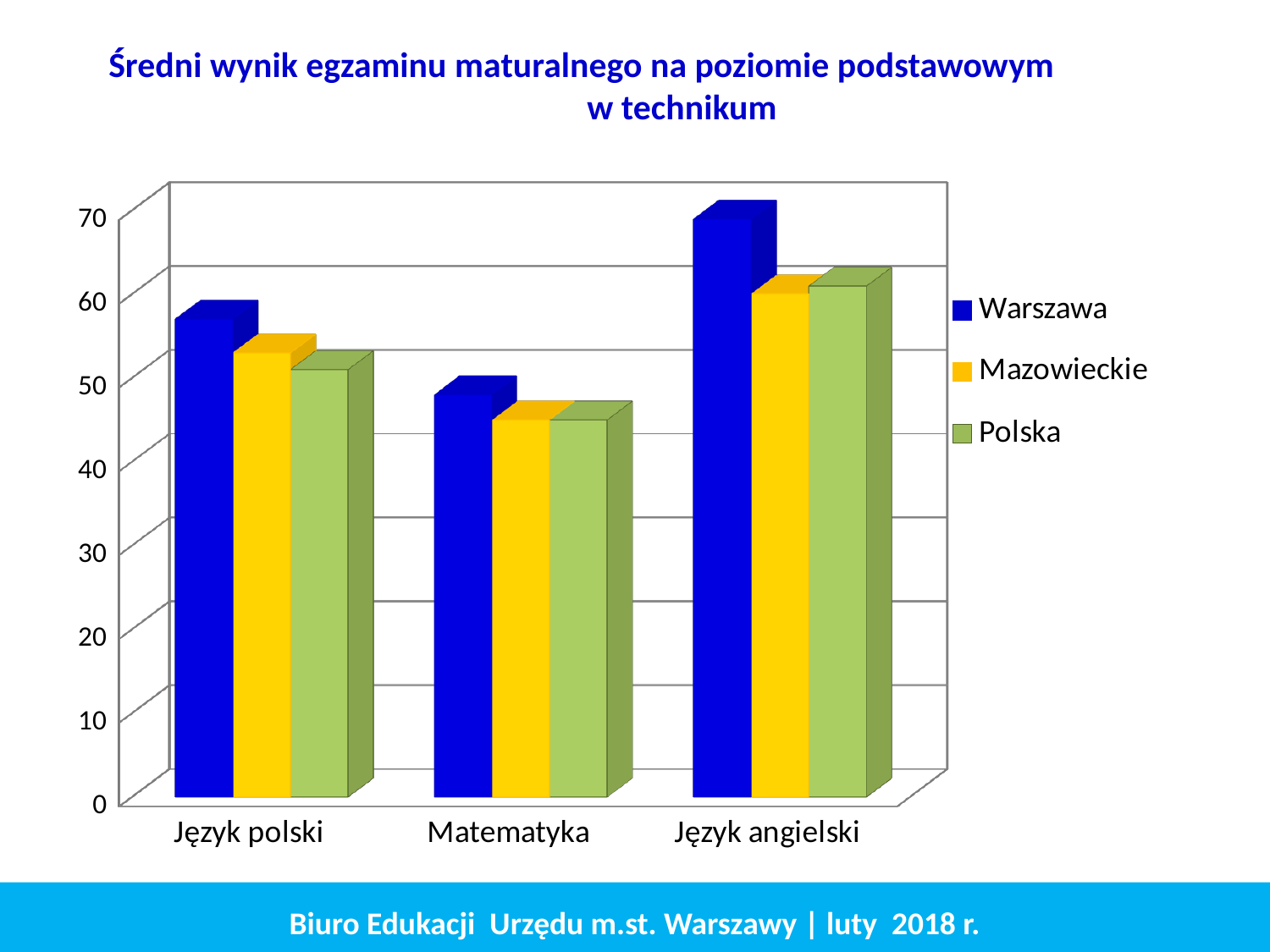
In which category is the Warszawa value lowest? Matematyka For Język angielski, which is larger: the Warszawa value or the Polska value? Warszawa What is the title of the chart? Średni wynik egzaminu maturalnego na poziomie podstawowym w technikum Is the Polska value for Język polski greater or less than 40? greater Is the Warszawa value for Język angielski greater or less than 60? greater Is the Mazowieckie value for Matematyka greater or less than 50? less Which series are listed in the legend? Warszawa, Mazowieckie, Polska How many categories are shown on the x axis? 3 For Język polski, which is larger: the Warszawa value or the Mazowieckie value? Warszawa How many series does the legend list? 3 What kind of chart is shown on the slide? bar chart In which category is the Warszawa value highest? Język angielski